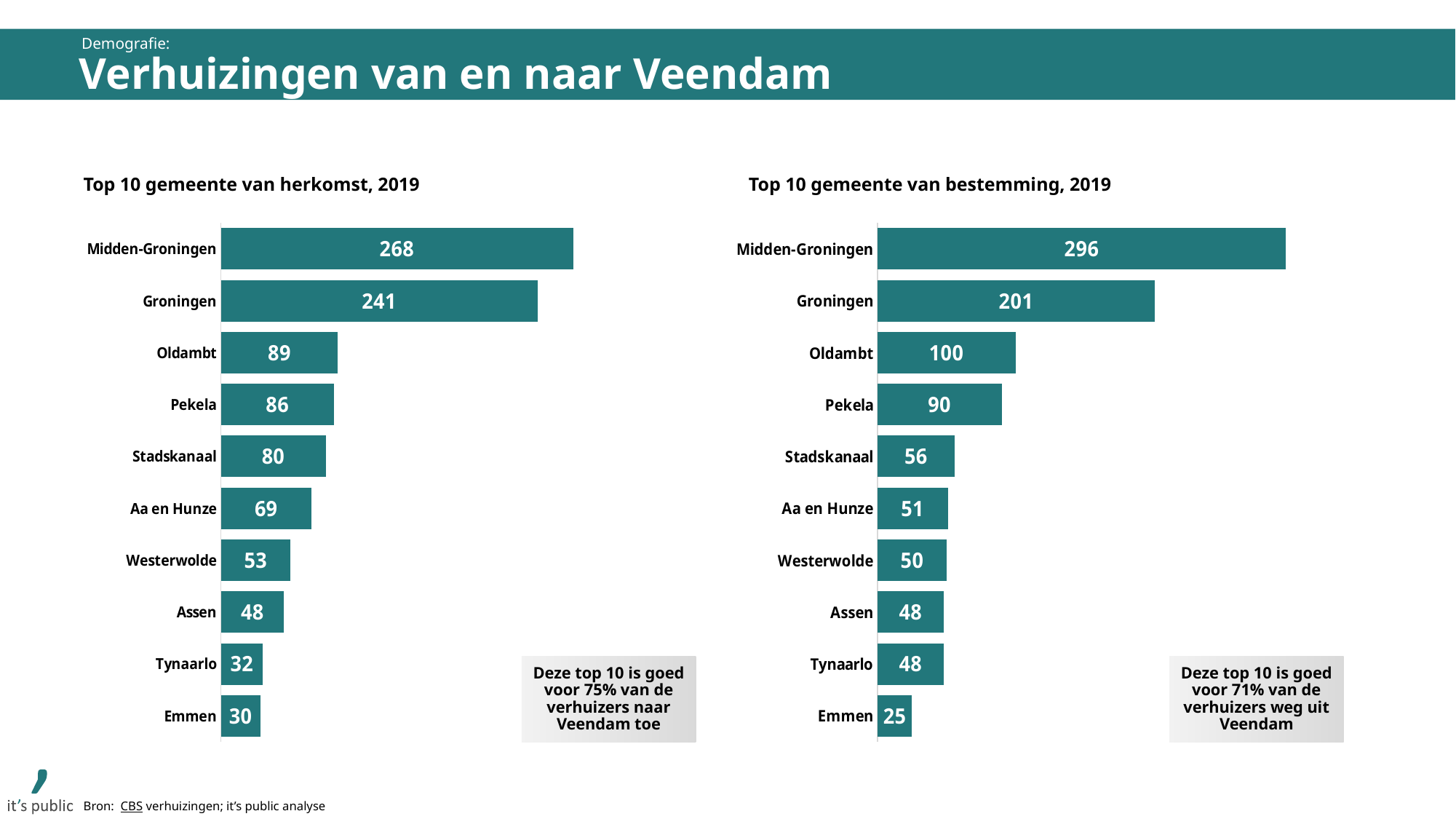
According to the text box on the 'Top 10 gemeente van bestemming, 2019' chart, what share of movers leaving Veendam does the top 10 account for? 71% In the 'Top 10 gemeente van herkomst, 2019' chart, what is the value for Groningen? 241 In the 'Top 10 gemeente van herkomst, 2019' chart, which municipality has the highest value? Midden-Groningen In the 'Top 10 gemeente van herkomst, 2019' chart, what is the value for Tynaarlo? 32 In the 'Top 10 gemeente van bestemming, 2019' chart, which municipality has the lowest value? Emmen In the 'Top 10 gemeente van bestemming, 2019' chart, what is the value for Oldambt? 100 In the 'Top 10 gemeente van herkomst, 2019' chart, what is the difference between Midden-Groningen and Groningen? 27 In the 'Top 10 gemeente van bestemming, 2019' chart, which is larger: Stadskanaal or Aa en Hunze? Stadskanaal In the 'Top 10 gemeente van bestemming, 2019' chart, what is the difference between Midden-Groningen and Groningen? 95 What kind of chart is the 'Top 10 gemeente van bestemming, 2019' chart? Bar chart How many municipalities are shown in the 'Top 10 gemeente van herkomst, 2019' chart? 10 Which is larger: the value for Pekela in the 'Top 10 gemeente van herkomst, 2019' chart or in the 'Top 10 gemeente van bestemming, 2019' chart? Top 10 gemeente van bestemming, 2019